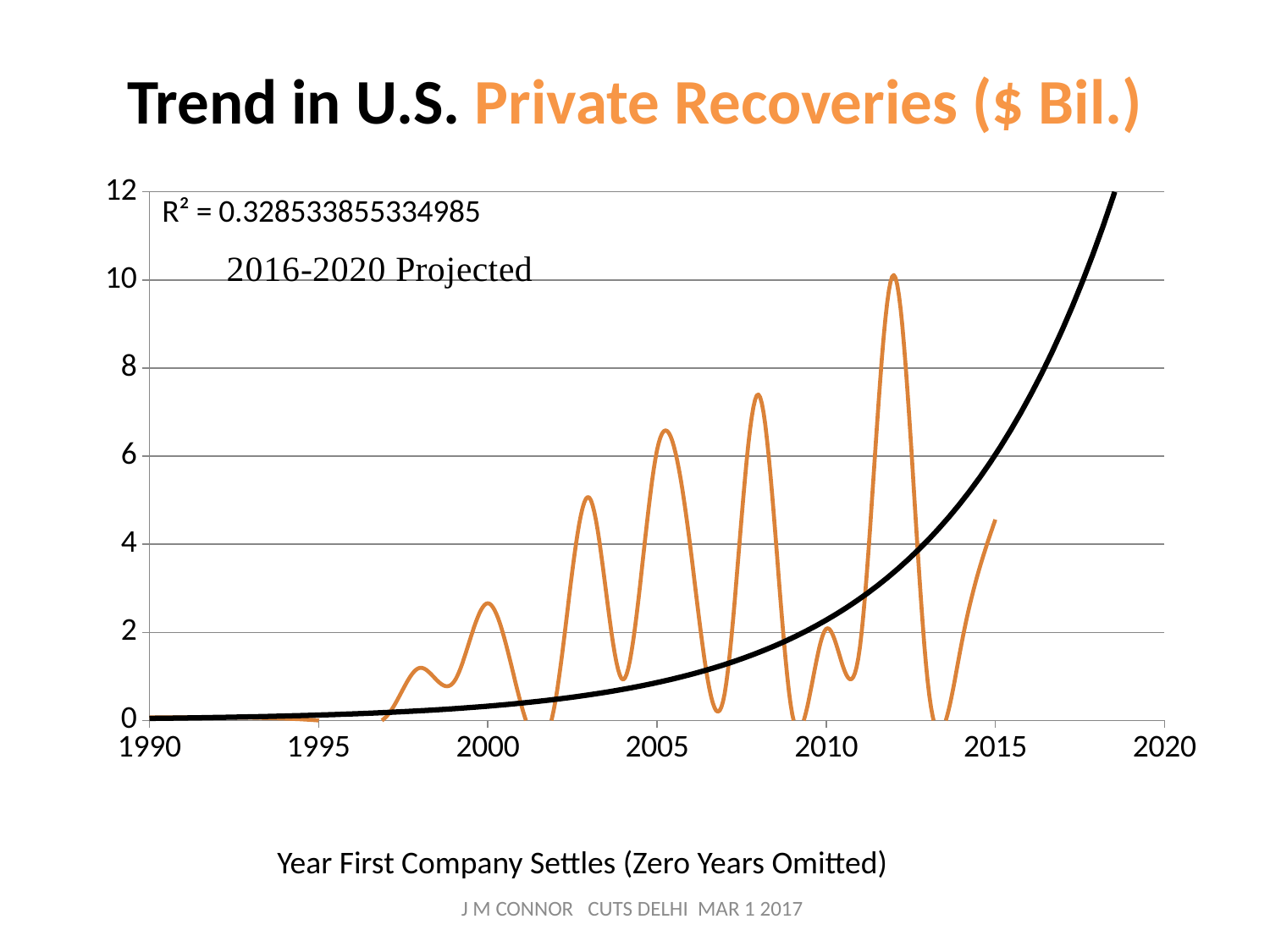
Is the value of the orange line at 2015 greater or less than 6? less Is the highest peak of the orange line, around 2012, greater or less than 8? greater In which year does the orange line reach its highest peak? 2012 Is the peak of the orange line around 2008 greater or less than 6? greater Does the black trend line rise or fall as the years increase from 1990 to 2020? rise At 2015, which line is higher, the orange line or the black trend line? the black trend line What is the title of the chart? Trend in U.S. Private Recoveries ($ Bil.) What R² value is printed on the chart? 0.328533855334985 What kind of chart is shown on the slide? line chart